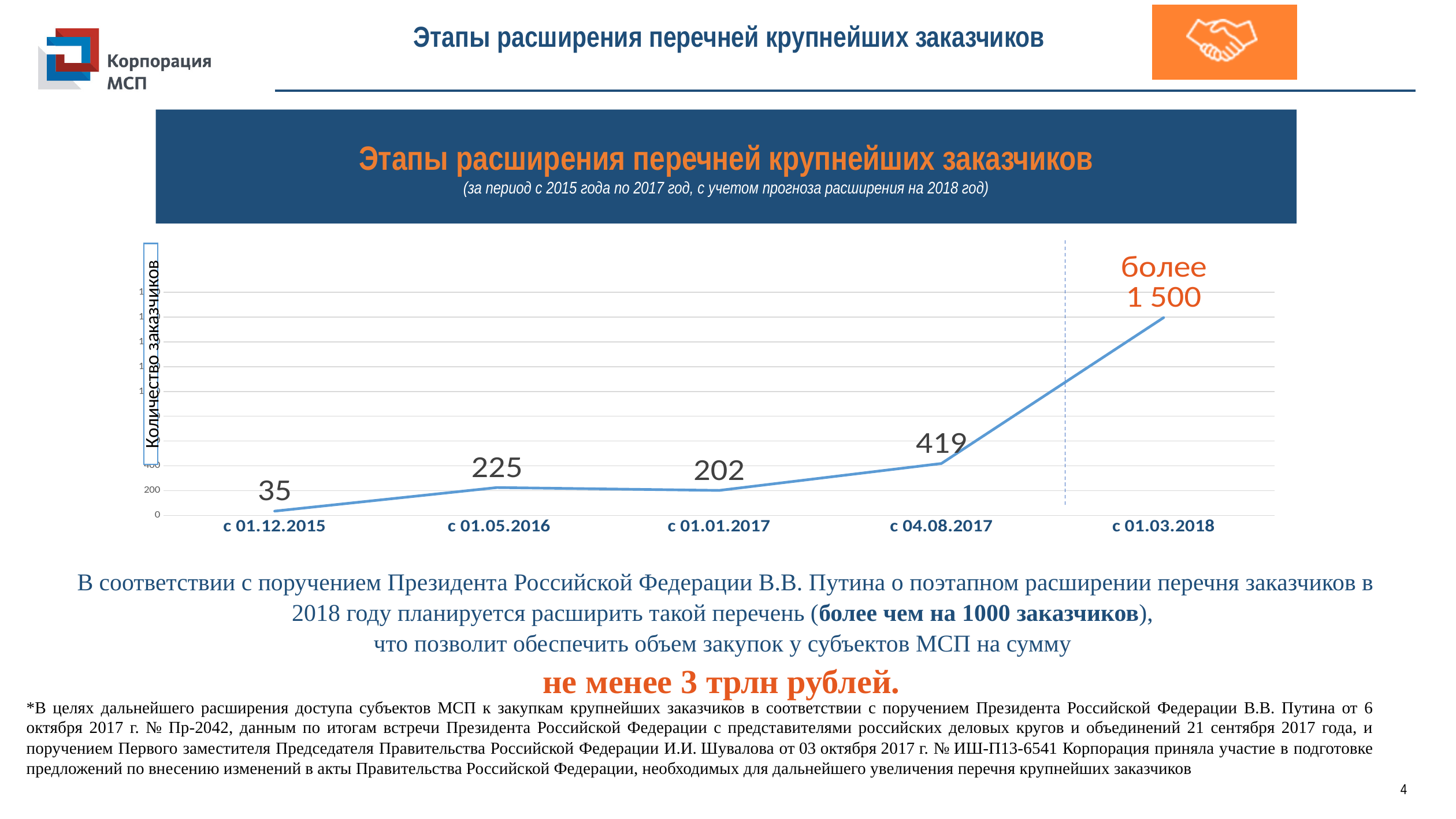
What is the value for с 01.05.2016? 225 What is the label of the vertical axis? Количество заказчиков Which category has the lowest value? с 01.12.2015 What is the value for с 04.08.2017? 419 What is the data label shown for с 01.03.2018? более 1 500 Which is larger, the value for с 01.05.2016 or the value for с 01.01.2017? с 01.05.2016 What is the value for с 01.12.2015? 35 Which category has the highest value? с 01.03.2018 How many data points are plotted on the chart? 5 What is the value for с 01.01.2017? 202 What is the difference between the values for с 04.08.2017 and с 01.01.2017? 217 What kind of chart is shown on the slide? line chart